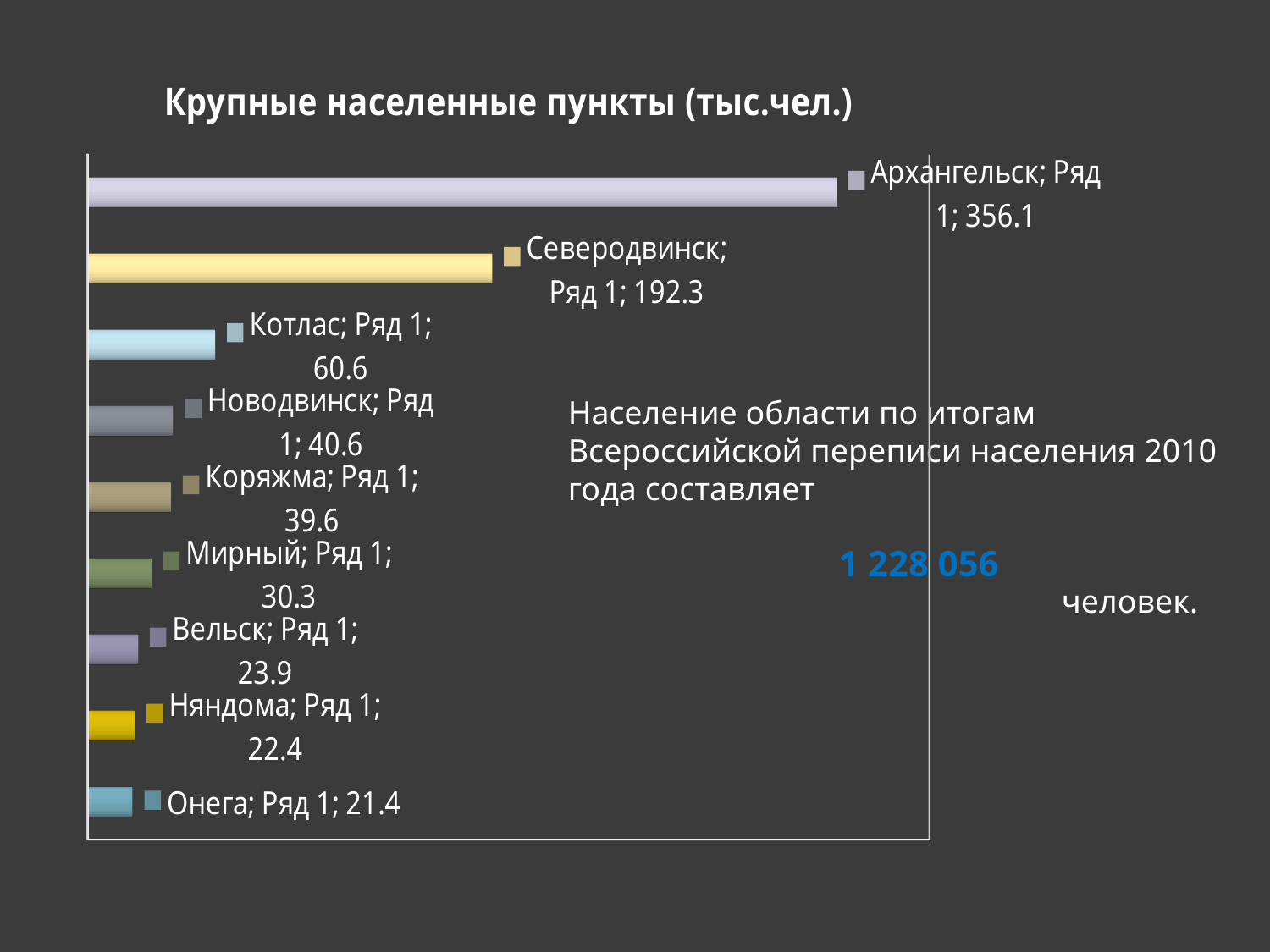
What is the value for Архангельск? 356.1 What is the value for Котлас? 60.6 Which city has the lowest value? Онега How many cities are shown in the chart? 9 Which is larger, the value for Мирный or the value for Вельск? Мирный What is the difference between the values for Архангельск and Северодвинск? 163.8 What is the value for Северодвинск? 192.3 Which city has the highest value? Архангельск What is the difference between the values for Новодвинск and Коряжма? 1.0 What is the title of the chart? Крупные населенные пункты (тыс.чел.) What is the value for Онега? 21.4 What kind of chart is this? bar chart